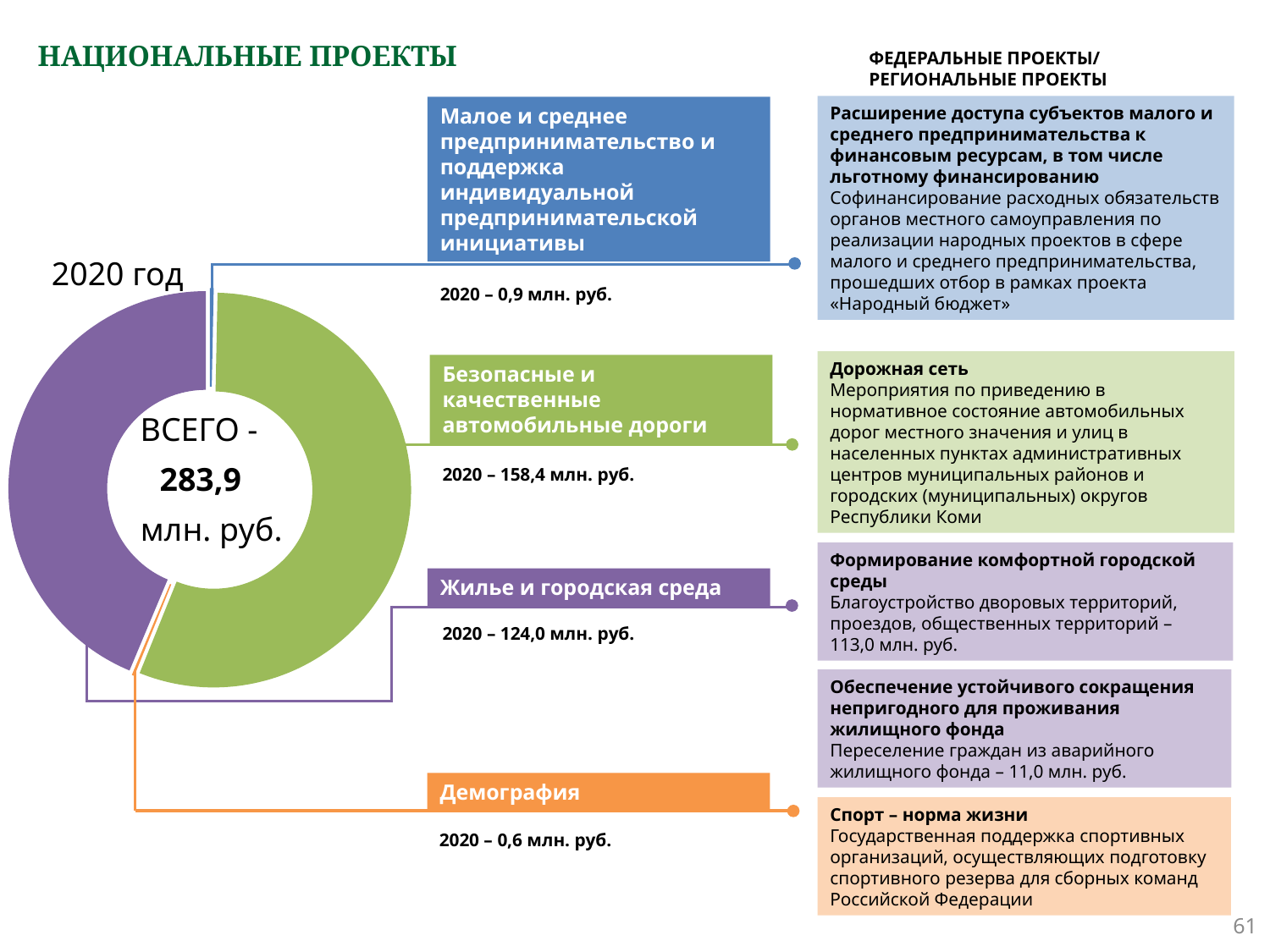
What is the 2020 value for «Жилье и городская среда»? 124,0 млн. руб. What kind of chart is shown on the slide? Donut (pie) chart What is the difference between the values for «Безопасные и качественные автомобильные дороги» and «Жилье и городская среда»? 34,4 млн. руб. Which national project has the smallest value in the donut chart? Демография What is the 2020 value for «Малое и среднее предпринимательство и поддержка индивидуальной предпринимательской инициативы»? 0,9 млн. руб. What is the 2020 value for «Безопасные и качественные автомобильные дороги»? 158,4 млн. руб. Which national project has the largest share of the donut chart? Безопасные и качественные автомобильные дороги What total value is shown in the centre of the donut chart? 283,9 млн. руб. What is the 2020 value for «Демография»? 0,6 млн. руб. Which is larger: the value for «Жилье и городская среда» or for «Демография»? Жилье и городская среда How many segments (national projects) does the donut chart have? 4 Which year does the donut chart represent? 2020 год